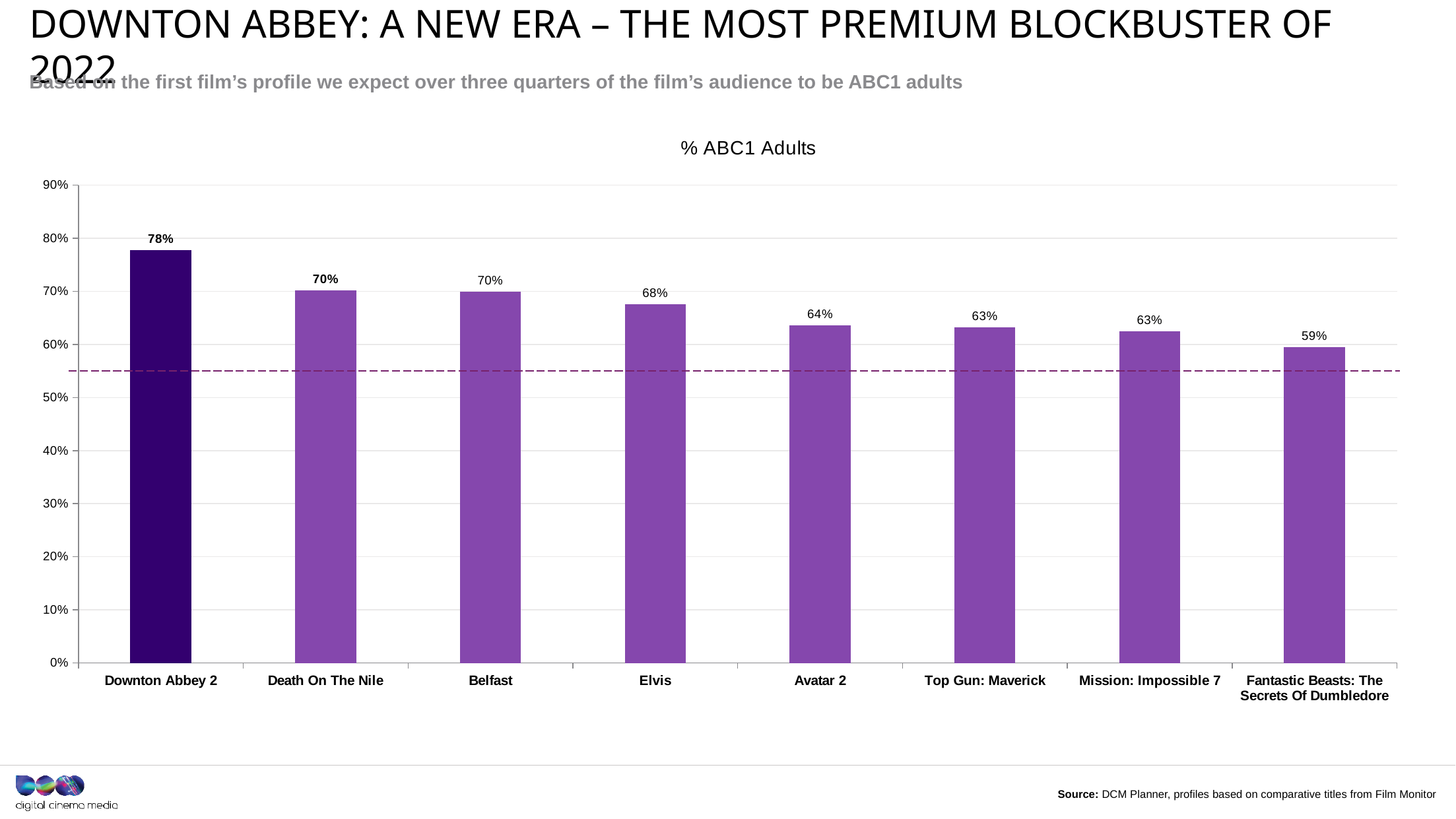
Which has a higher % ABC1 Adults, Elvis or Top Gun: Maverick? Elvis What is the % ABC1 Adults value for Fantastic Beasts: The Secrets Of Dumbledore? 59% What is the difference in % ABC1 Adults between Downton Abbey 2 and Avatar 2? 14% Which film has the lowest % ABC1 Adults? Fantastic Beasts: The Secrets Of Dumbledore Is the value for Avatar 2 greater or less than 60%? greater What is the % ABC1 Adults value for Downton Abbey 2? 78% What is the % ABC1 Adults value for Elvis? 68% What is the title of the chart? % ABC1 Adults How many films are shown on the chart? 8 Do the values rise or fall from left to right across the chart? Fall Which film has the highest % ABC1 Adults? Downton Abbey 2 What kind of chart is shown on the slide? Bar chart